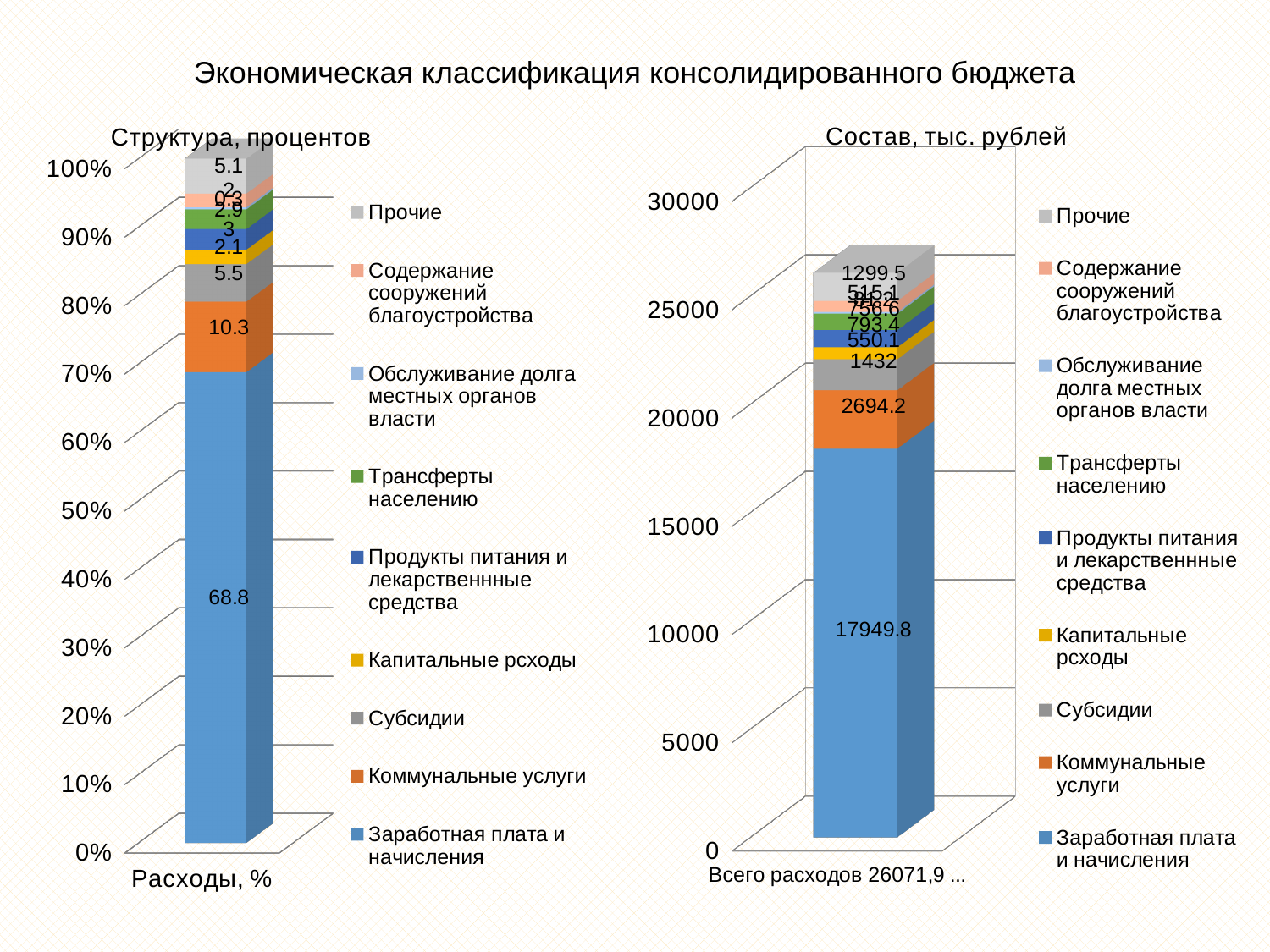
On the left chart (Структура, процентов), what is the value for Заработная плата и начисления? 68.8 On the right chart (Состав, тыс. рублей), what is the difference between Коммунальные услуги and Субсидии? 1262.2 On the left chart (Структура, процентов), what is the value for Коммунальные услуги? 10.3 On the right chart (Состав, тыс. рублей), what is the total of all expenses shown in the stacked bar, as printed on the slide? 26071,9 On the right chart (Состав, тыс. рублей), what is the value for Коммунальные услуги? 2694.2 On the left chart (Структура, процентов), which category has the largest segment? Заработная плата и начисления On the left chart (Структура, процентов), what is the value for Субсидии? 5.5 On the right chart (Состав, тыс. рублей), what is the value for Прочие? 1299.5 On the right chart (Состав, тыс. рублей), what is the value for Заработная плата и начисления? 17949.8 On the right chart (Состав, тыс. рублей), which is larger: Капитальные рсходы or Продукты питания и лекарственнные средства? Продукты питания и лекарственнные средства How many series does the legend of the left chart (Структура, процентов) list? 9 What kind of chart is the right chart (Состав, тыс. рублей)? Stacked bar chart